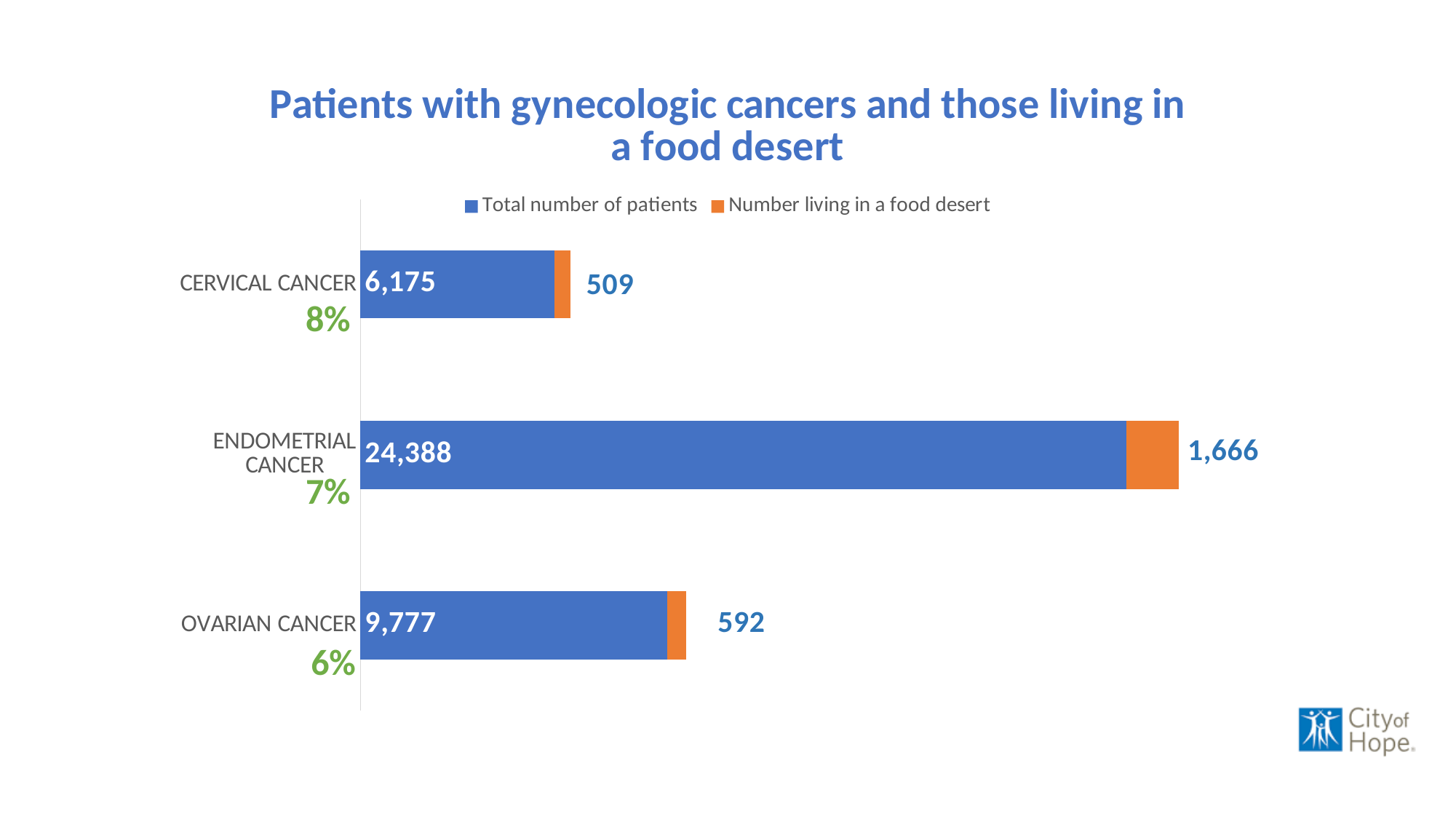
Which cancer type has the highest total number of patients? Endometrial cancer Which cancer type has the lowest number of patients living in a food desert? Cervical cancer What type of chart is shown on the slide? Bar chart How many cervical cancer patients live in a food desert? 509 How many cancer types are shown in the chart? 3 Which is larger: the total number of ovarian cancer patients or the total number of cervical cancer patients? Ovarian cancer What percentage is shown in green next to the cervical cancer label? 8% How many series does the legend list? 2 What is the difference between the total number of endometrial cancer patients and the total number of ovarian cancer patients? 14,611 What is the total number of patients for endometrial cancer? 24,388 What is the number of ovarian cancer patients living in a food desert? 592 How many more ovarian cancer patients than cervical cancer patients live in a food desert? 83